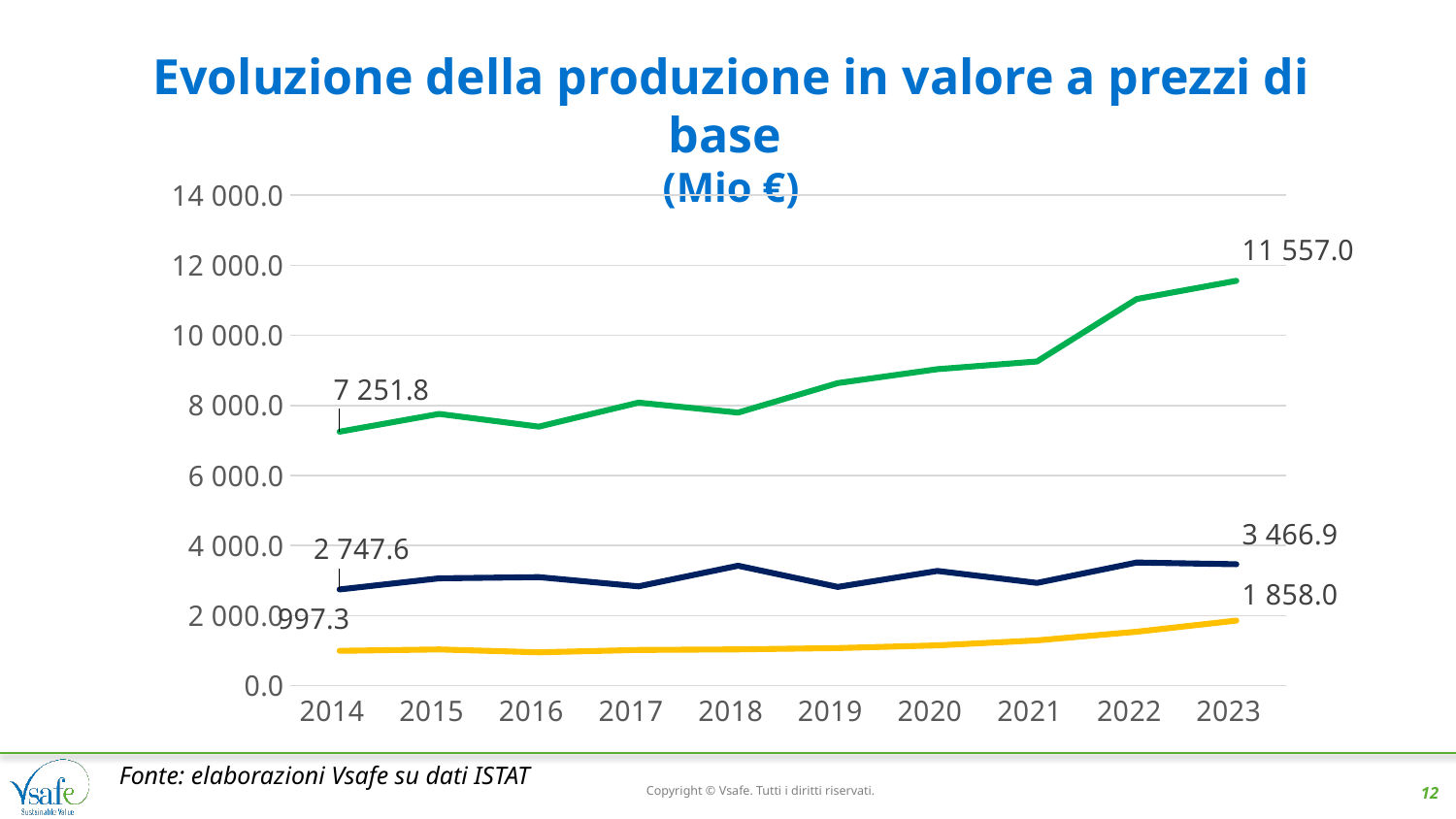
What is the value labelled for the dark blue line in 2023? 3 466.9 What is the value labelled for the yellow line in 2014? 997.3 What is the value labelled for the green line in 2014? 7 251.8 What is the value labelled for the green line in 2023? 11 557.0 Which line has the highest value in 2023: green, dark blue or yellow? green Does the green line generally rise or fall from 2014 to 2023? rise How many years are shown on the x axis of the chart? 10 What is the difference between the yellow line's 2023 value (1 858.0) and its 2014 value (997.3)? 860.7 How many lines are plotted on the chart? 3 What kind of chart is shown on the slide? line chart By how much did the green line's value increase from 2014 (7 251.8) to 2023 (11 557.0)? 4 305.2 Is the value of the green line in 2022 greater or less than 10 000.0? greater